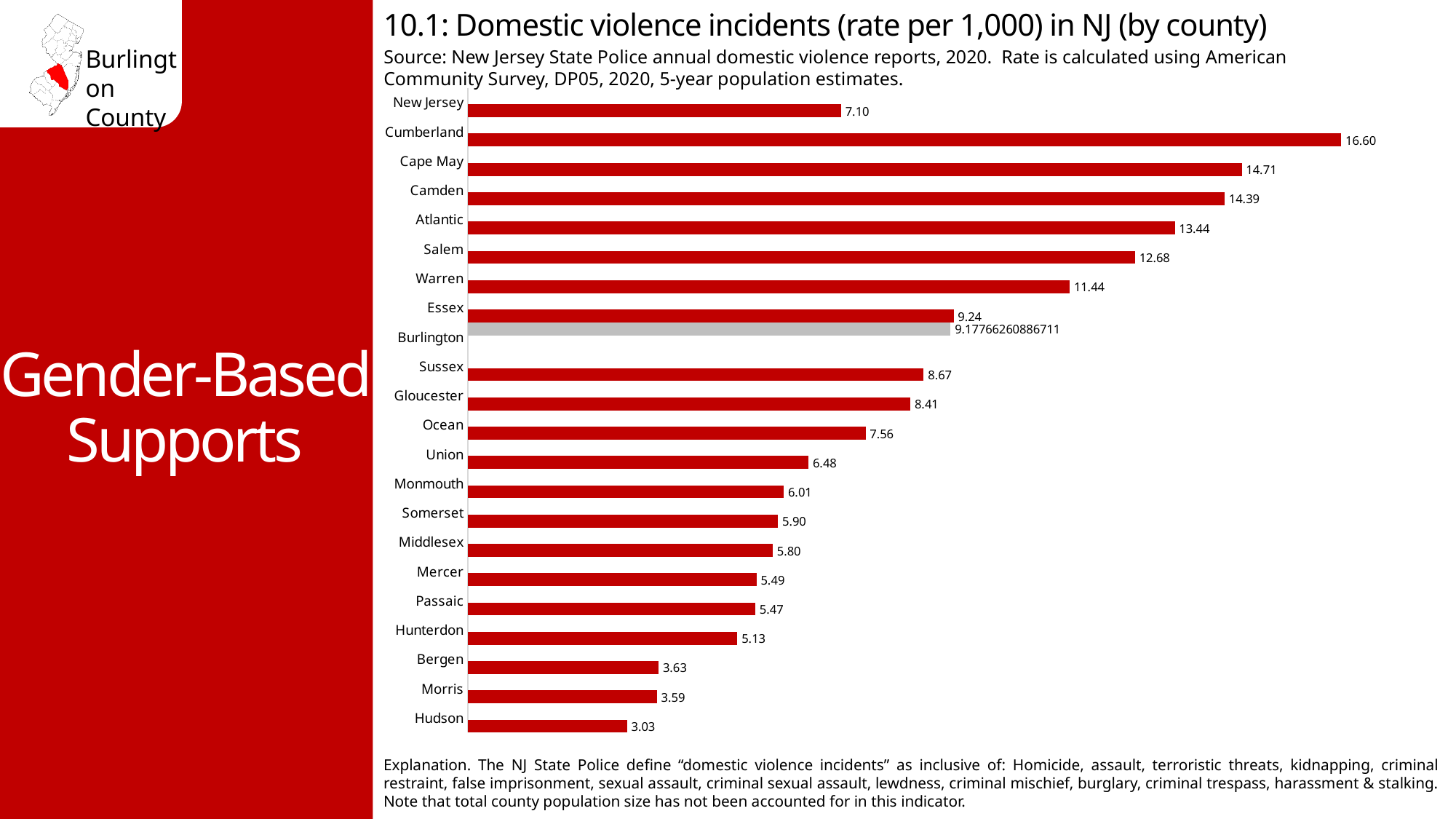
What is the difference between the rates for Cumberland and Hudson? 13.57 What is the domestic violence incident rate per 1,000 for Cumberland County? 16.60 Which county has the highest domestic violence incident rate? Cumberland What is the domestic violence incident rate per 1,000 for Hunterdon County? 5.13 Which has a higher domestic violence incident rate, Ocean or Union? Ocean What type of chart is shown on the slide? Bar chart Which county has the lowest domestic violence incident rate? Hudson How many bars are plotted in the chart? 22 What value is labelled on the Burlington bar? 9.17766260886711 What is the domestic violence incident rate per 1,000 shown for New Jersey overall? 7.10 Which has a higher domestic violence incident rate, Essex or Sussex? Essex What is the difference between the rates for Cape May and Camden? 0.32